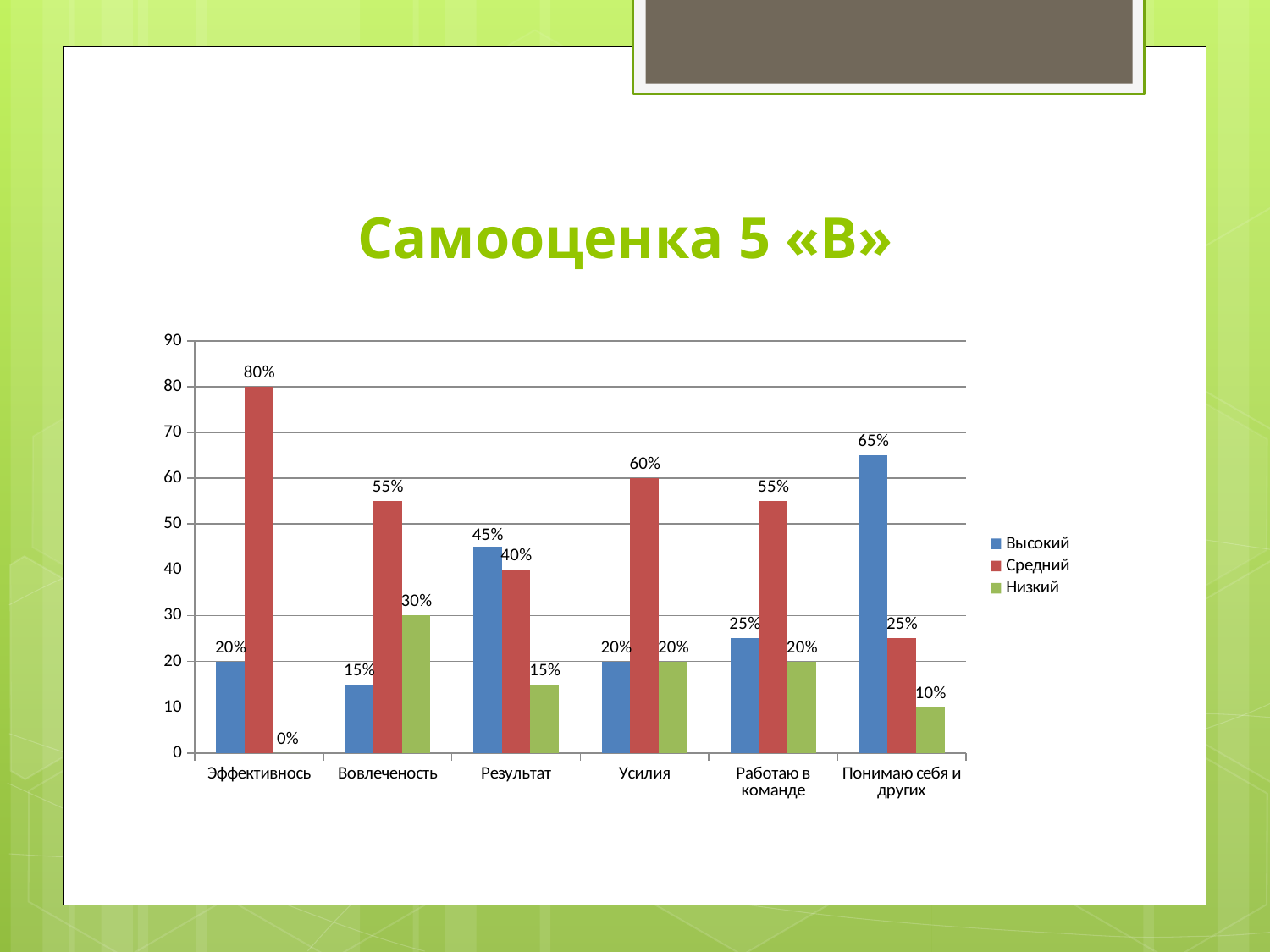
What is the difference between the Средний and Высокий values for Усилия? 40% For Результат, which is larger: Высокий or Средний? Высокий What is the value of Низкий for Вовлеченость? 30% What is the title of the chart? Самооценка 5 «В» What is the value of Средний for Работаю в команде? 55% How many categories are shown on the x axis? 6 What is the value of Средний for Эффективнось? 80% What type of chart is shown on the slide? bar chart Which category has the highest Высокий value? Понимаю себя и других How many series does the legend list? 3 Which category has the lowest Низкий value? Эффективнось What is the value of Высокий for Понимаю себя и других? 65%